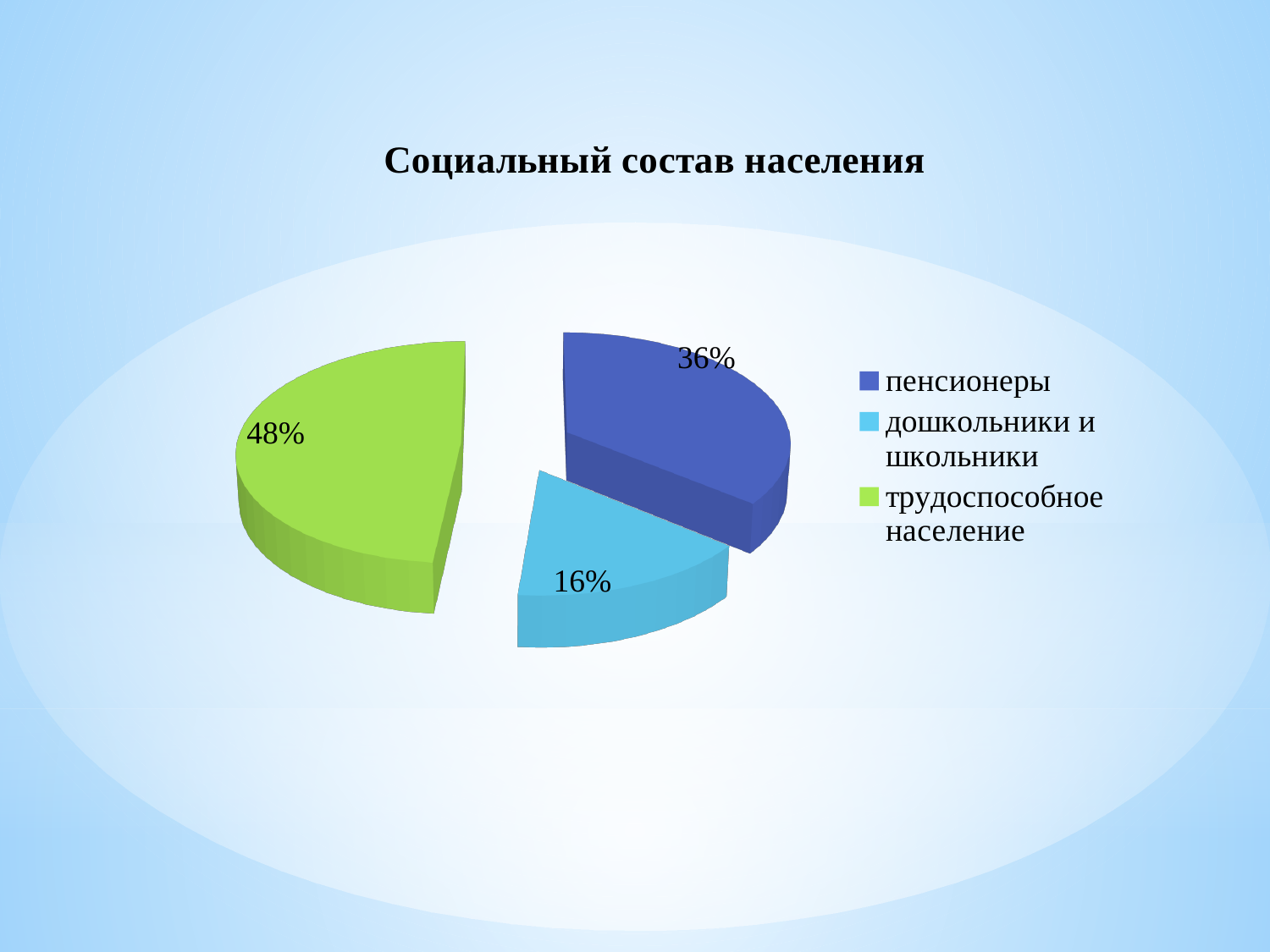
What colour is the slice for трудоспособное население? green What share of the pie is labelled for трудоспособное население? 48% How many entries does the legend list? 3 How many slices does the pie chart have? 3 What is the title of the chart? Социальный состав населения What share of the pie is labelled for пенсионеры? 36% What is the difference in percentage points between трудоспособное население and пенсионеры? 12 Which is larger, the share for пенсионеры or the share for дошкольники и школьники? пенсионеры Which category has the smallest slice of the pie? дошкольники и школьники What share of the pie is labelled for дошкольники и школьники? 16% Which category has the largest slice of the pie? трудоспособное население What kind of chart is shown on the slide? pie chart